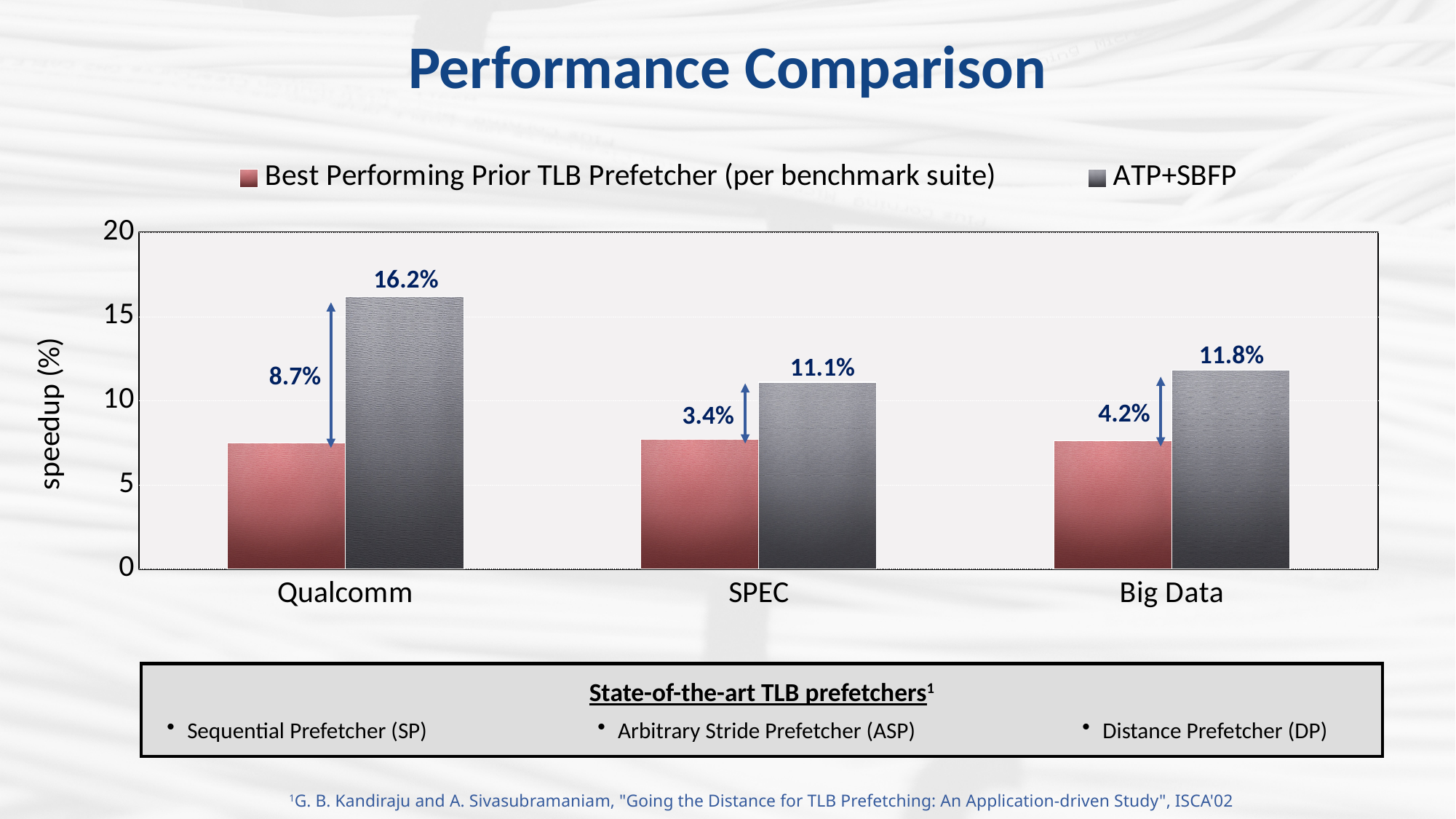
Is the speedup of the best performing prior TLB prefetcher for Qualcomm greater or less than 10? less What is the ATP+SBFP speedup for Big Data? 11.8% How many series does the legend list? 2 What is the ATP+SBFP speedup for Qualcomm? 16.2% Which benchmark suite has the lowest ATP+SBFP speedup? SPEC Is the ATP+SBFP speedup larger for SPEC or for Big Data? Big Data What kind of chart is shown on the slide? bar chart What is the ATP+SBFP speedup for SPEC? 11.1% How many benchmark suites are shown on the x axis? 3 What is the labeled gap between ATP+SBFP and the best performing prior TLB prefetcher for Qualcomm? 8.7% What is the labeled gap between ATP+SBFP and the best performing prior TLB prefetcher for Big Data? 4.2% Which benchmark suite has the highest ATP+SBFP speedup? Qualcomm